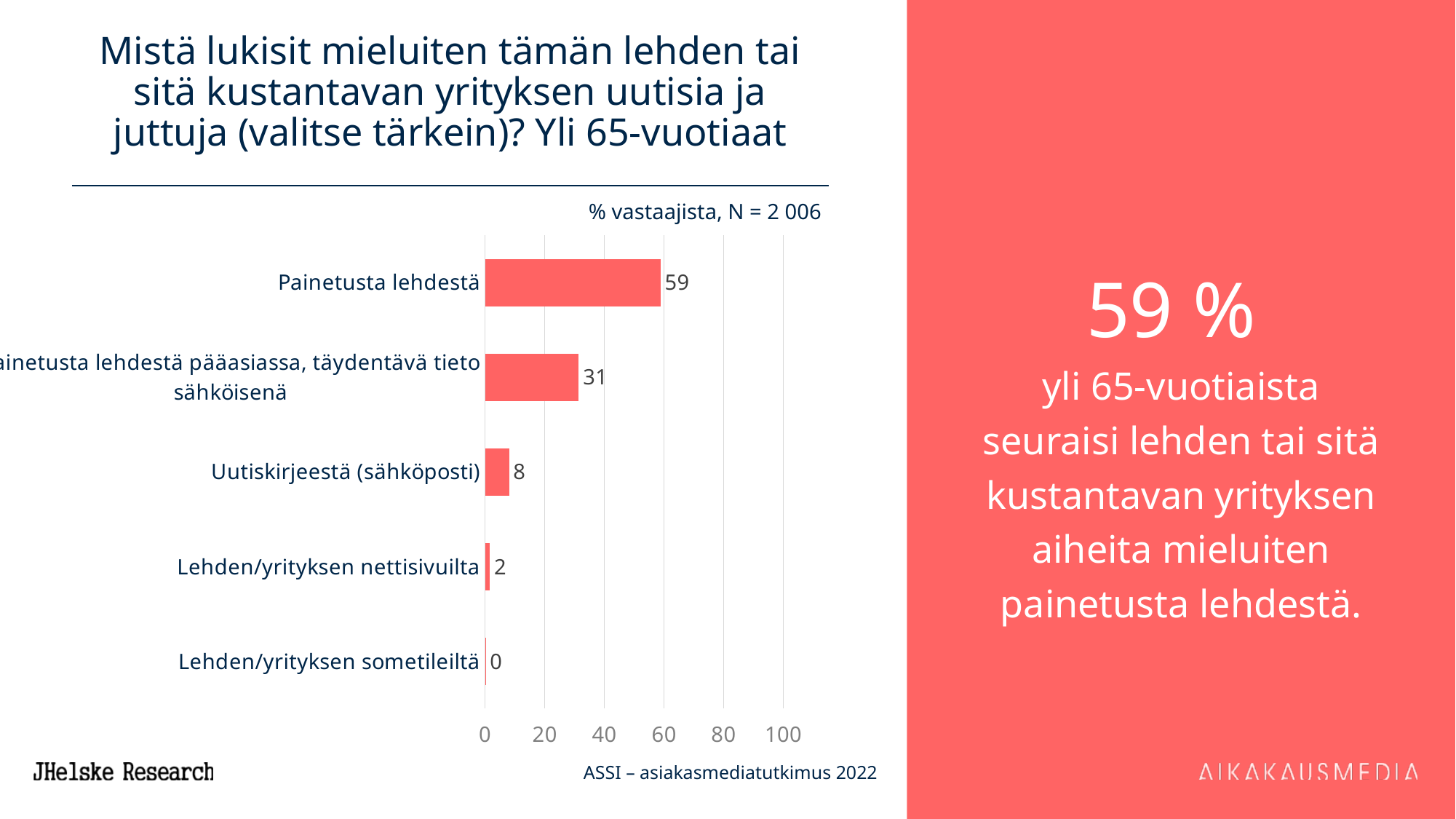
Which category has the lowest value? Lehden/yrityksen sometileiltä What is the sample size (N) stated above the chart? 2 006 What is the value for Uutiskirjeestä (sähköposti)? 8 What is the value for Lehden/yrityksen nettisivuilta? 2 Which is larger, the value for Uutiskirjeestä (sähköposti) or the value for Lehden/yrityksen nettisivuilta? Uutiskirjeestä (sähköposti) Which category has the highest value? Painetusta lehdestä What kind of chart is shown on the slide? bar chart How many categories are shown in the chart? 5 What is the value for Lehden/yrityksen sometileiltä? 0 What is the difference between the values for Painetusta lehdestä and Uutiskirjeestä (sähköposti)? 51 What is the value for Painetusta lehdestä? 59 Is the value for Painetusta lehdestä greater or less than 40? greater